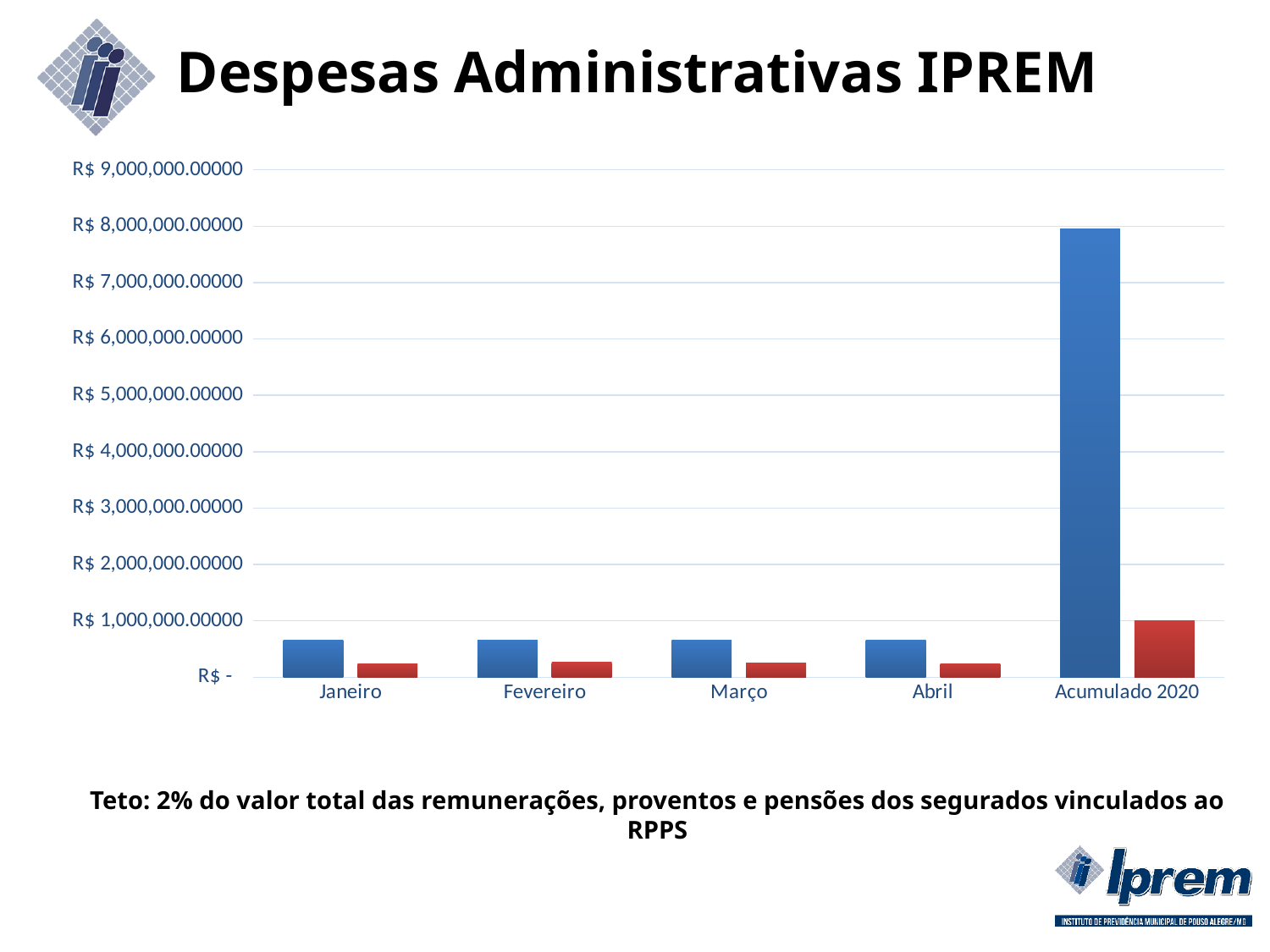
Is the blue bar for Janeiro greater or less than R$ 1,000,000.00000? less Is the red bar for Março greater or less than R$ 1,000,000.00000? less Which category has the tallest blue bar? Acumulado 2020 Is the blue bar for Acumulado 2020 greater or less than R$ 5,000,000.00000? greater What is the title of the slide containing the chart? Despesas Administrativas IPREM Which category has the tallest red bar? Acumulado 2020 How many bars are shown for each category on the chart? 2 For Acumulado 2020, which bar is taller, the blue one or the red one? the blue one How many categories are shown on the x axis of the chart? 5 For Fevereiro, which bar is taller, the blue one or the red one? the blue one What kind of chart is shown on the slide? bar chart